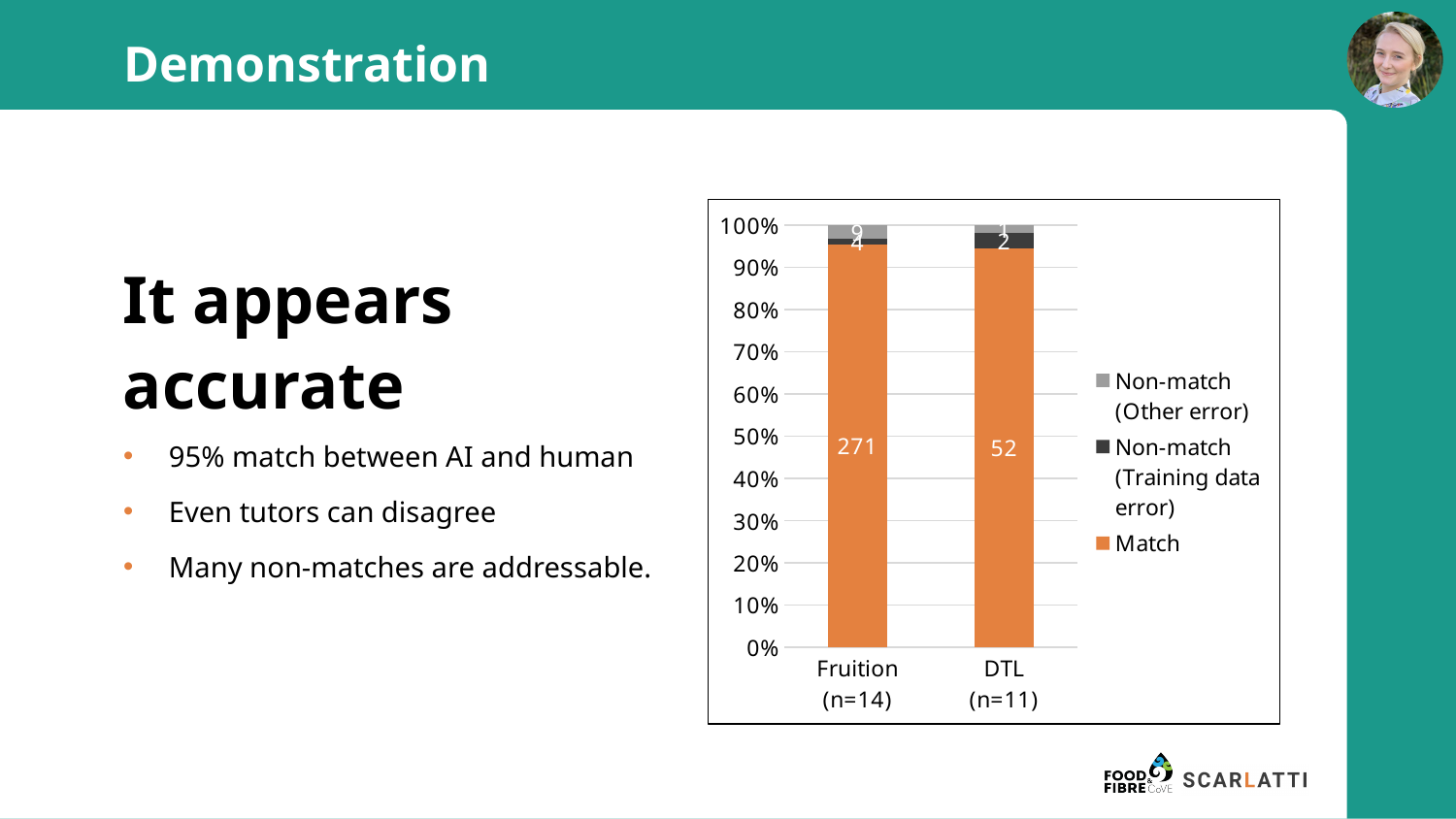
Which category has the larger Match value, Fruition (n=14) or DTL (n=11)? Fruition (n=14) How many categories are shown on the x axis of the chart? 2 What is the Match value for Fruition (n=14)? 271 What kind of chart is shown on the slide? Stacked bar chart Is the Match share of the Fruition (n=14) bar greater or less than 90%? greater How many series does the chart legend list? 3 What is the Non-match (Training data error) value for Fruition (n=14)? 4 What is the Match value for DTL (n=11)? 52 What is the Non-match (Training data error) value for DTL (n=11)? 2 What is the difference between the Match values for Fruition (n=14) and DTL (n=11)? 219 Which series is shown in orange in the chart? Match What is the Non-match (Other error) value for Fruition (n=14)? 9